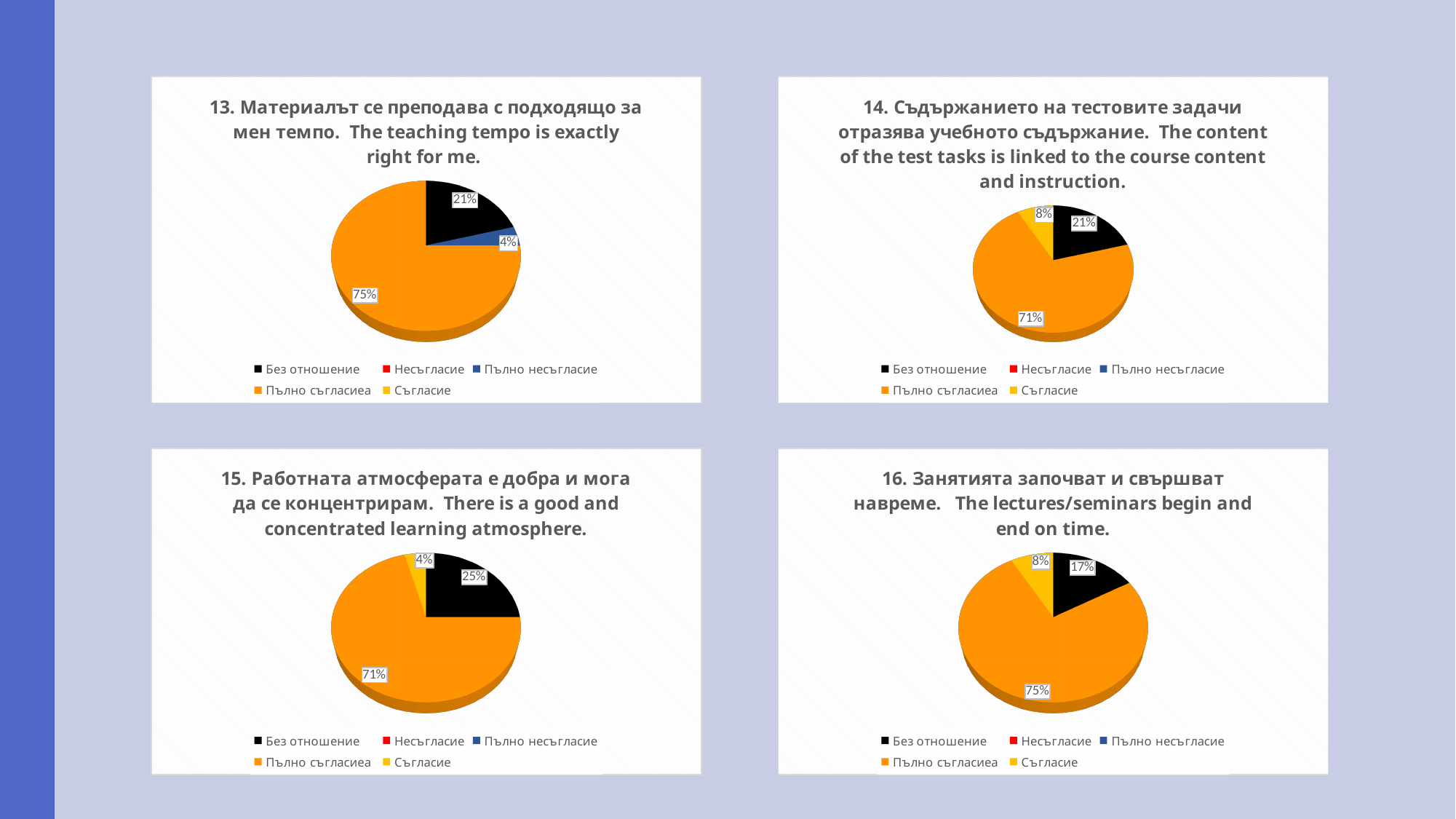
In the top-left chart (question 13), what percentage is shown for the 'Пълно несъгласие' slice? 4% In the top-right chart (question 14), what percentage is shown for 'Съгласие'? 8% In the bottom-left chart (question 15), what percentage is shown for 'Без отношение'? 25% How many entries does the legend of the top-left chart (question 13) list? 5 In the bottom-right chart (question 16), what percentage is shown for 'Пълно съгласиеа'? 75% In the top-left chart (question 13), what percentage is labelled for the 'Без отношение' slice? 21% In the top-left chart (question 13), what share of responses is 'Пълно съгласиеа'? 75% In the bottom-right chart (question 16), what is the difference between the 'Пълно съгласиеа' slice and the 'Без отношение' slice? 58% Which is larger in the bottom-left chart (question 15): the 'Без отношение' slice or the 'Съгласие' slice? Без отношение In the top-right chart (question 14), which category has the largest slice? Пълно съгласиеа What type of chart is used for question 16 in the bottom-right? Pie chart In the bottom-left chart (question 15), which labelled category has the smallest slice? Съгласие